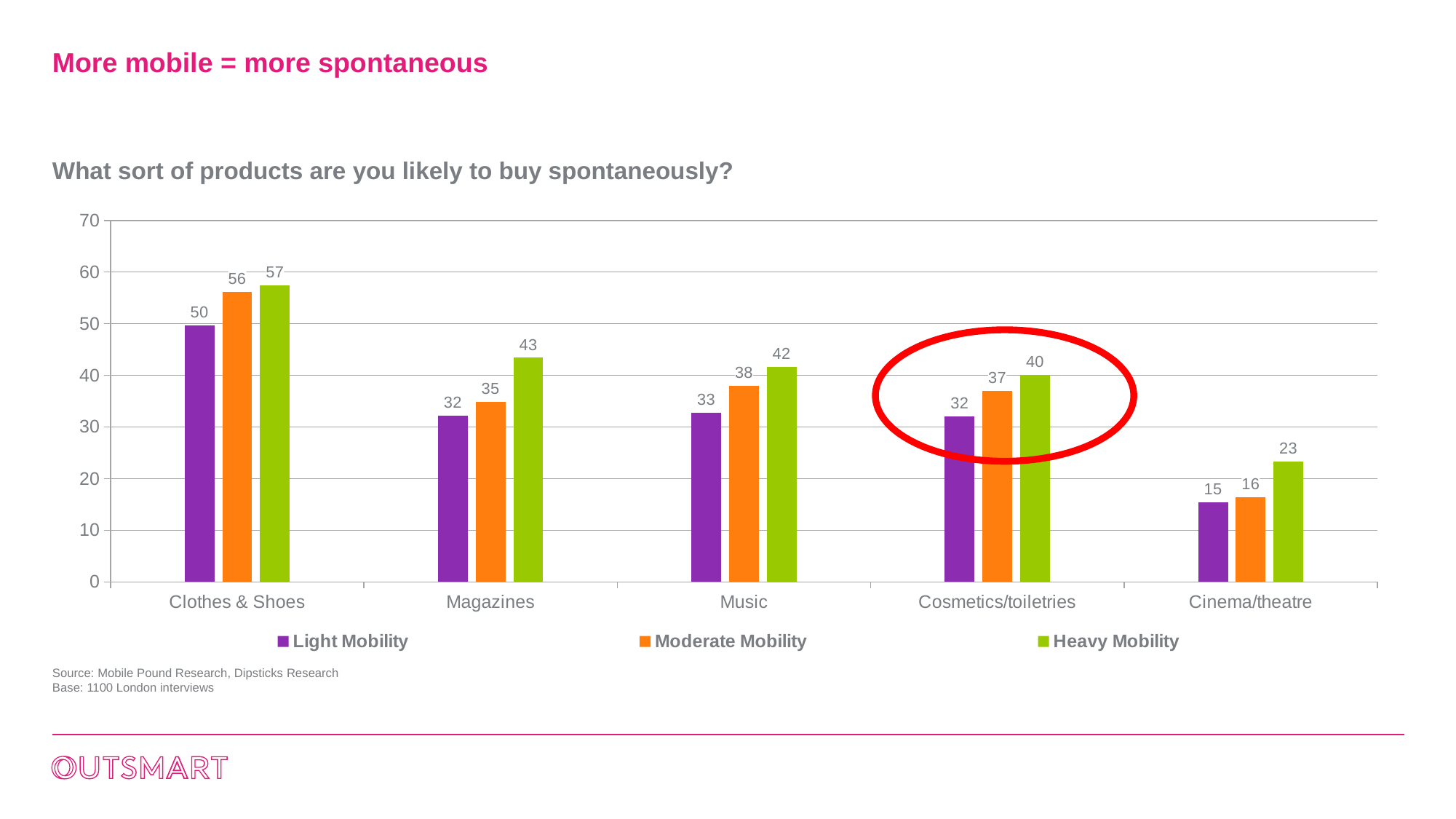
How many series does the legend list? 3 Which category has the lowest Light Mobility value? Cinema/theatre Is the Light Mobility value for Clothes & Shoes greater or less than 40? greater How many product categories are shown on the x axis? 5 Which category is circled in red on the chart? Cosmetics/toiletries What is the Light Mobility value for Cosmetics/toiletries? 32 Which category has the highest Heavy Mobility value? Clothes & Shoes What is the Moderate Mobility value for Music? 38 What is the difference between the Heavy Mobility and Light Mobility values for Magazines? 11 What kind of chart is shown on the slide? Bar chart Which is larger for Cinema/theatre: the Moderate Mobility value or the Heavy Mobility value? Heavy Mobility What is the Heavy Mobility value for Clothes & Shoes? 57